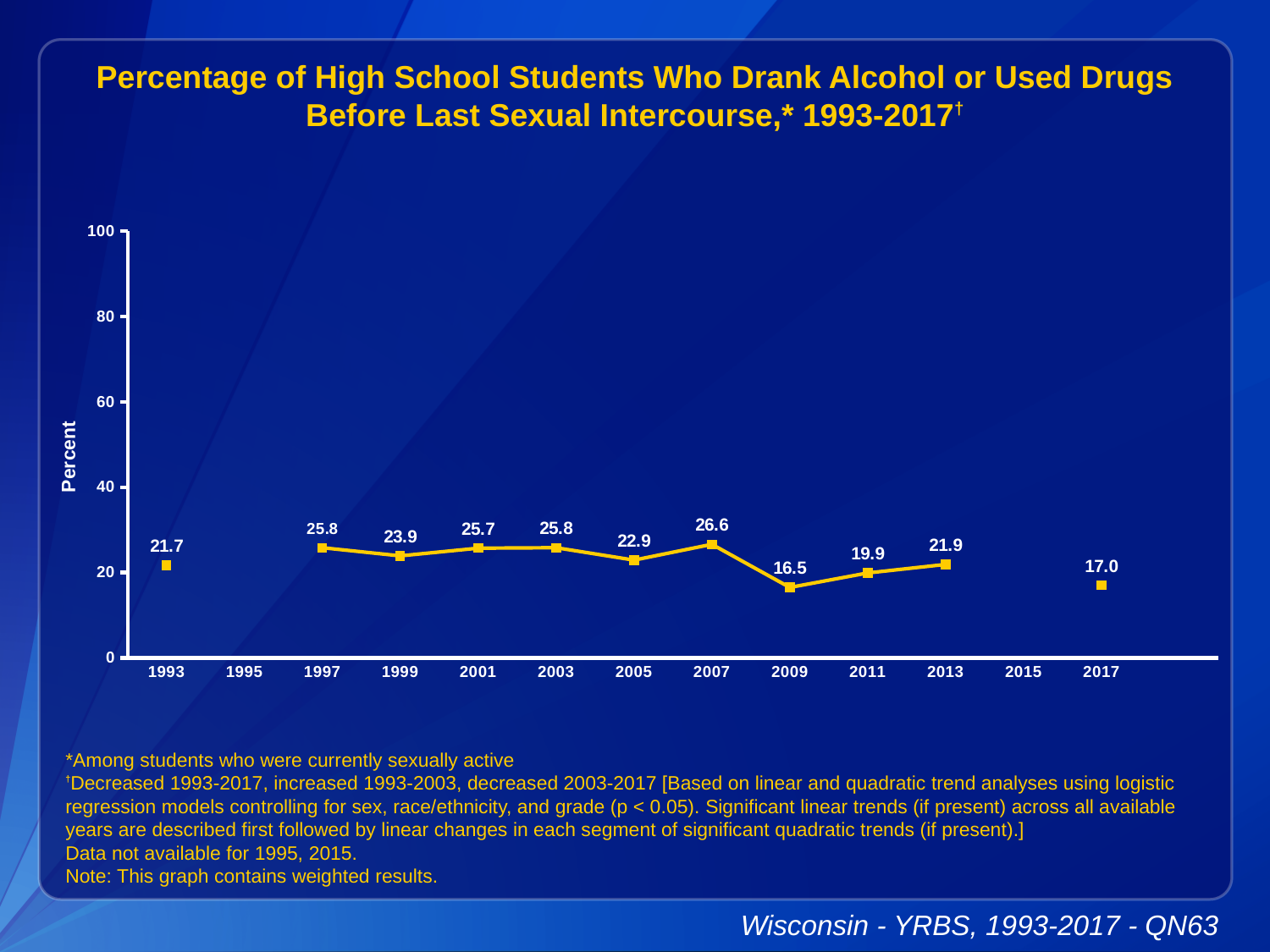
Which year has the highest value? 2007 Which year has the lowest value? 2009 What is the value for 1993? 21.7 Is the value for 2009 greater or less than 20? less What kind of chart is this? line chart What is the value for 2017? 17.0 What is the label on the y axis? Percent How many years have data points plotted on the chart? 11 What is the value for 2007? 26.6 What is the difference between the values for 2007 and 2009? 10.1 Which is larger, the value for 2011 or the value for 2013? 2013 Do the values rise or fall from 2007 to 2009? fall